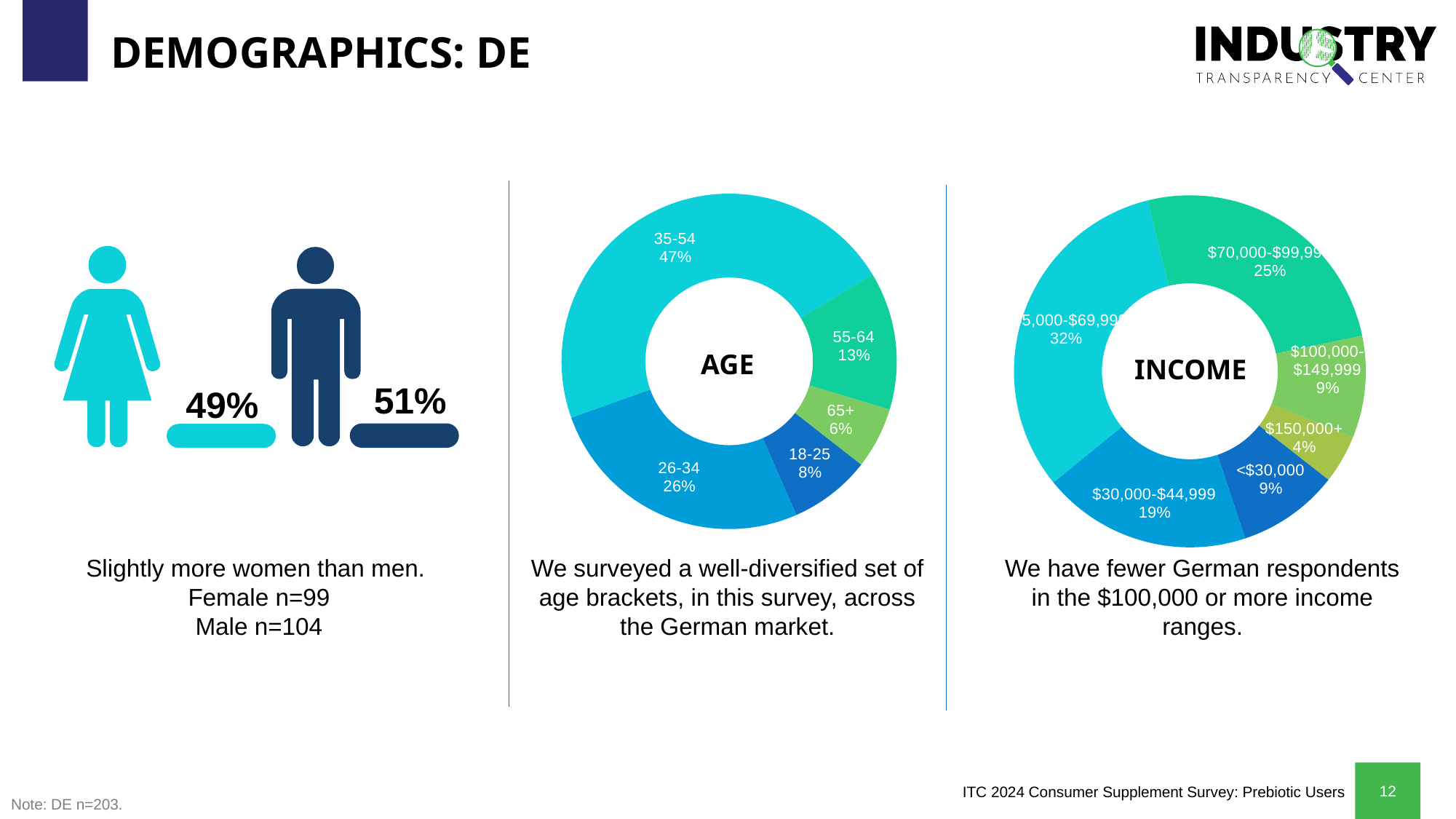
In the AGE chart, how many age brackets are shown? 5 In the AGE chart, what is the difference between the 26-34 share and the 55-64 share? 13% What kind of chart is the AGE chart? Pie chart (donut) In the AGE chart, what share of respondents are aged 18-25? 8% In the INCOME chart, which income range has the smallest share? $150,000+ In the AGE chart, what share of respondents are aged 35-54? 47% In the INCOME chart, what share of respondents earn $30,000-$44,999? 19% In the AGE chart, which age bracket has the smallest share? 65+ In the AGE chart, which age bracket has the largest share? 35-54 In the INCOME chart, what share of respondents earn $150,000+? 4% In the INCOME chart, which is larger: the $70,000-$99,999 share or the $30,000-$44,999 share? $70,000-$99,999 In the INCOME chart, how many income ranges are shown? 6